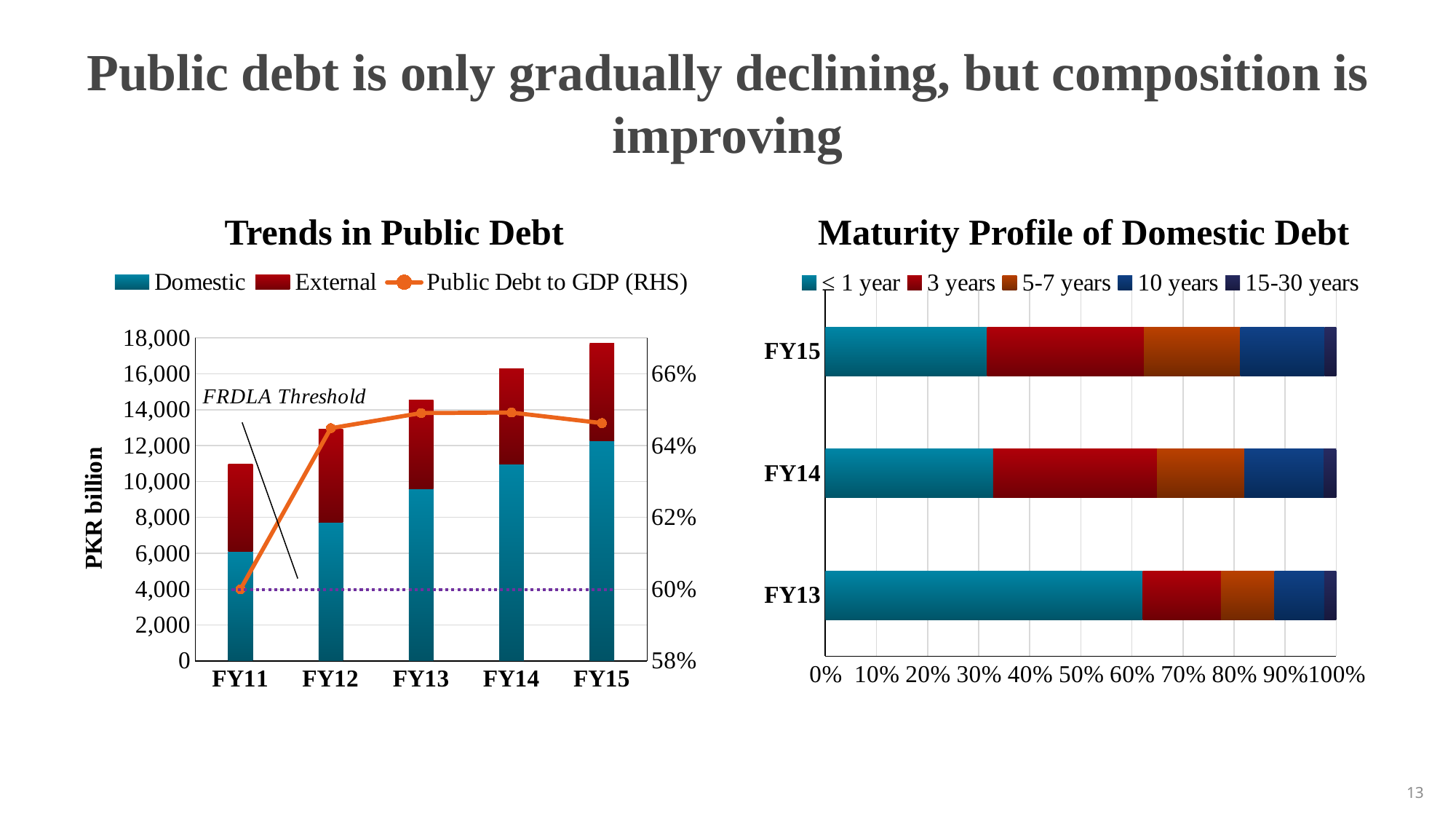
On the 'Maturity Profile of Domestic Debt' chart, how many fiscal years are shown? 3 On the 'Trends in Public Debt' chart, what kind of chart is it? A stacked bar chart combined with a line On the 'Trends in Public Debt' chart, which fiscal year has the highest total public debt? FY15 On the 'Maturity Profile of Domestic Debt' chart, how many series does the legend list? 5 On the 'Trends in Public Debt' chart, which fiscal year has the lowest total public debt? FY11 On the 'Maturity Profile of Domestic Debt' chart, which fiscal year has the largest share of debt maturing in ≤ 1 year? FY13 On the 'Trends in Public Debt' chart, how many series does the legend list? 3 On the 'Trends in Public Debt' chart, is the Domestic value for FY11 greater or less than 8,000? less On the 'Maturity Profile of Domestic Debt' chart, is the ≤ 1 year share for FY13 greater or less than 50%? greater On the 'Trends in Public Debt' chart, does the Domestic debt rise or fall from FY11 to FY15? rises On the 'Trends in Public Debt' chart, how many fiscal years are shown on the x axis? 5 On the 'Trends in Public Debt' chart, is the total public debt for FY15 greater or less than 16,000? greater